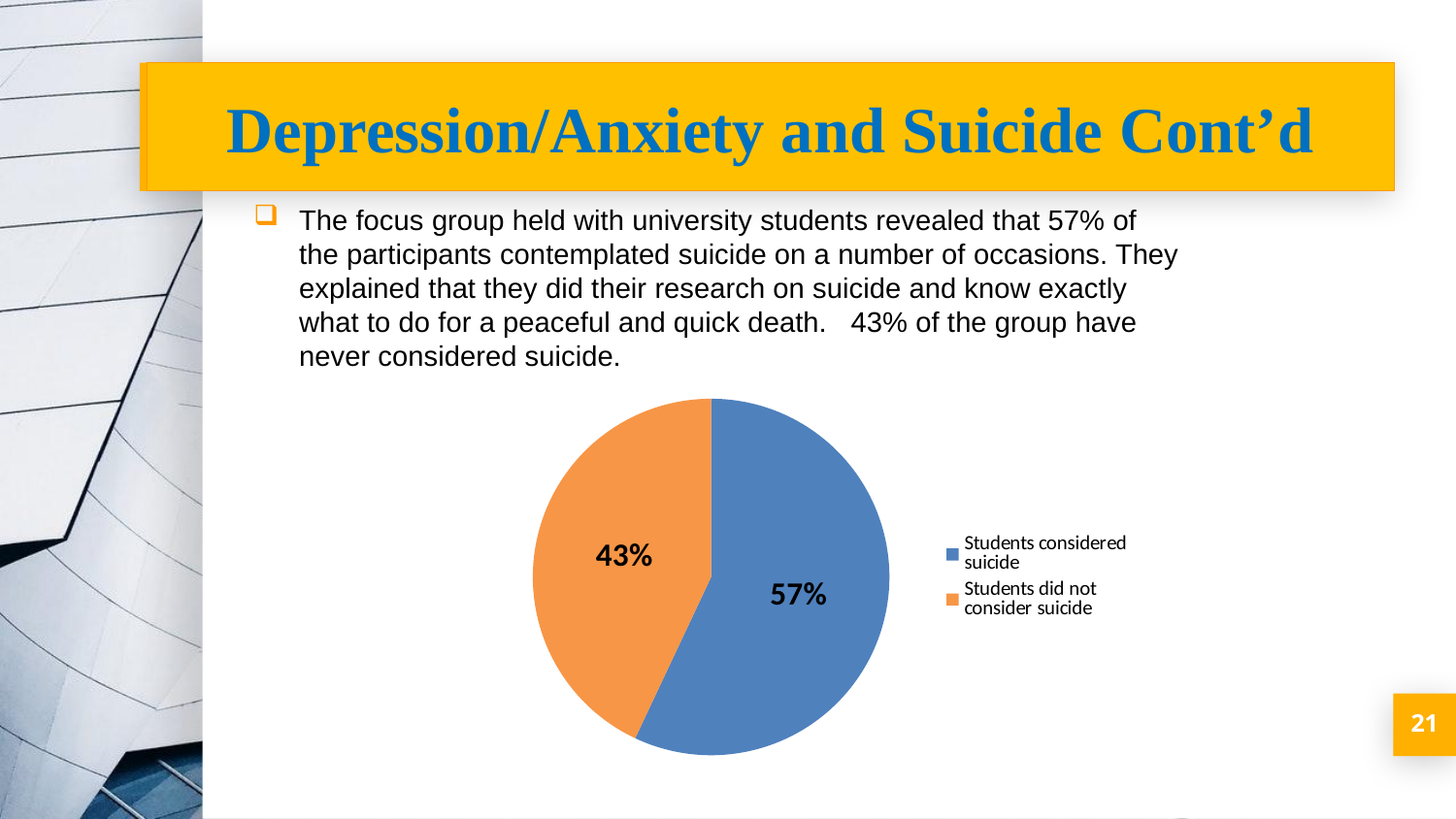
What is the difference in percentage points between students who considered suicide and those who did not? 14 What percentage of students considered suicide according to the pie chart? 57% What kind of chart is shown on the slide? Pie chart What is the total of the two slices in the pie chart? 100% How many entries does the legend list? 2 How many slices does the pie chart have? 2 What percentage of students did not consider suicide according to the pie chart? 43% Which is larger: the share of students who considered suicide or the share who did not? Students considered suicide Which category has the smallest slice in the pie chart? Students did not consider suicide What colour is the slice for students who considered suicide? Blue What colour is the slice for students who did not consider suicide? Orange Which category has the largest slice in the pie chart? Students considered suicide